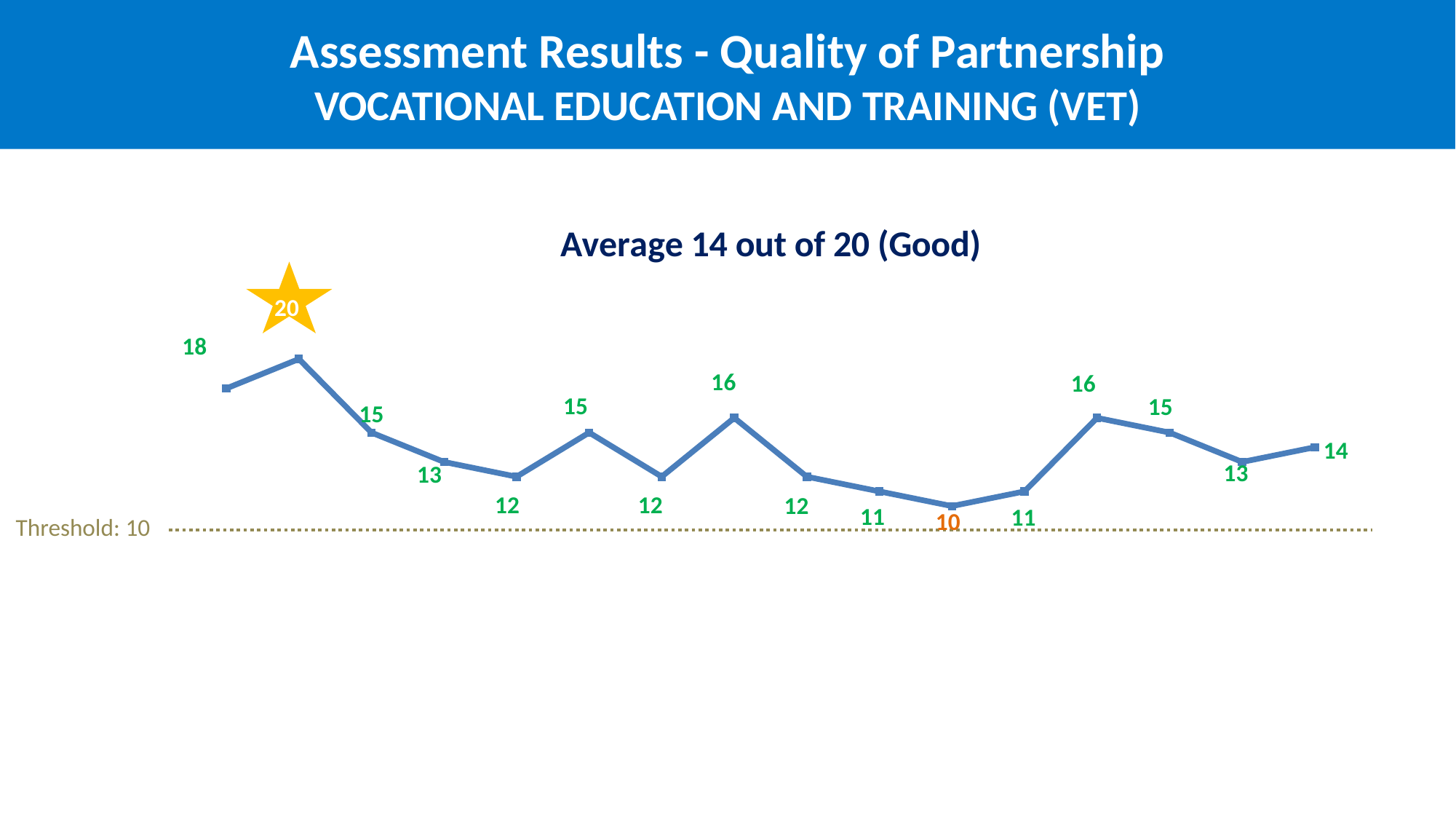
What is the lowest value plotted on the line? 10 What is the value of the first data point on the line? 18 What threshold value is marked by the dotted line? 10 How many data points are plotted on the line? 16 What is the value of the data point marked with the star? 20 Which is larger, the first data point or the last data point? the first data point (18) What average score is stated above the chart? 14 out of 20 (Good) What is the difference between the highest value (20) and the lowest value (10) on the line? 10 What is the difference between the first data point (18) and the last data point (14)? 4 What is the value of the last data point on the line? 14 What is the highest value plotted on the line? 20 What kind of chart is shown on the slide? line chart